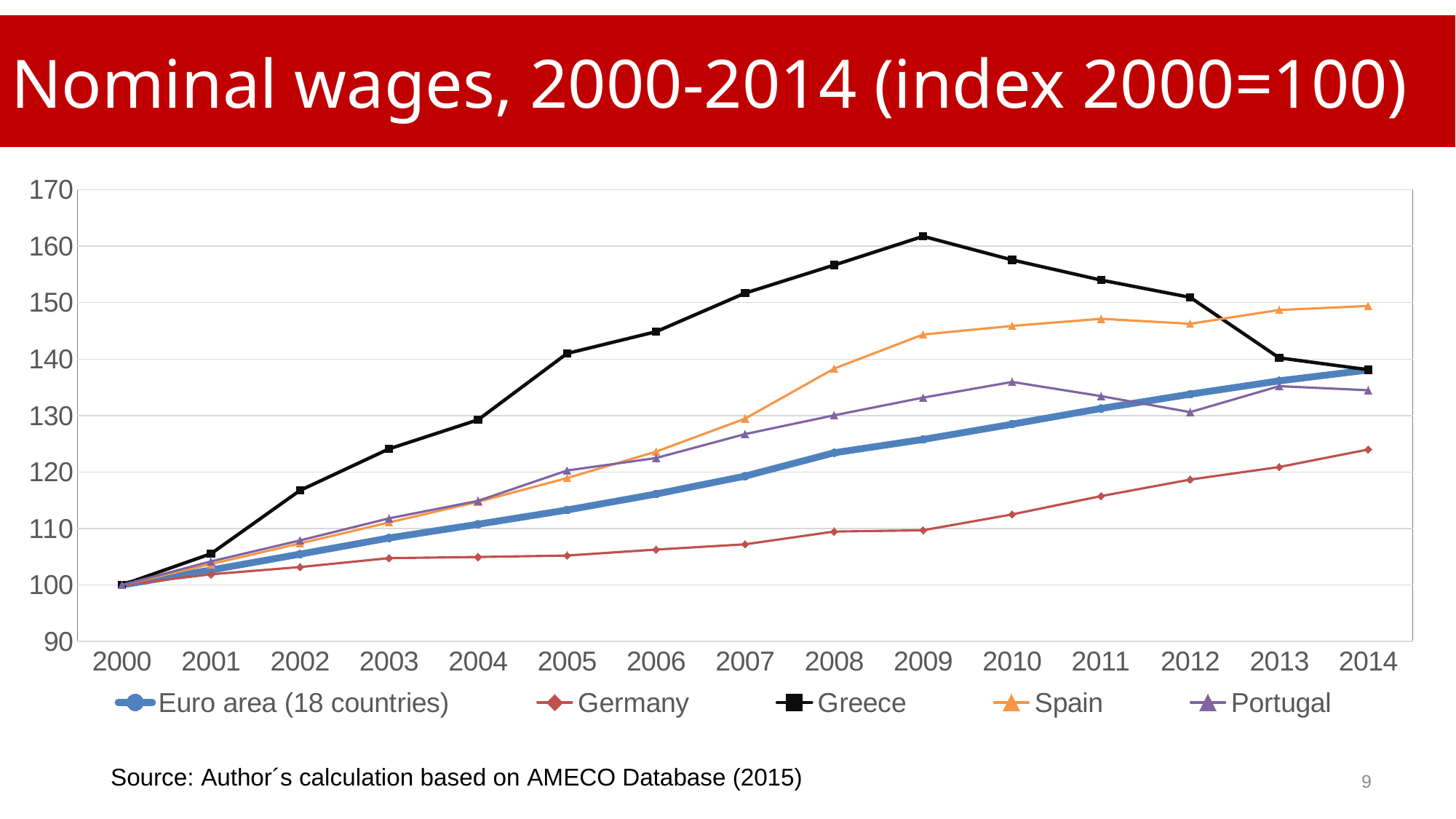
Which series has the highest value in 2009? Greece Which series has the lowest value in 2014? Germany Does the Germany series rise or fall from 2000 to 2014? Rises Is the value for Greece in 2009 greater or less than 150? greater What is the title of the slide? Nominal wages, 2000-2014 (index 2000=100) What kind of chart is shown on the slide? Line chart How many years are plotted along the x axis? 15 Which series has the highest value in 2014? Spain In 2014, which is larger: the value for Greece or the value for Spain? Spain Is the value for Germany in 2014 greater or less than 130? less How many series does the legend list? 5 What is the index value for Greece in 2000? 100